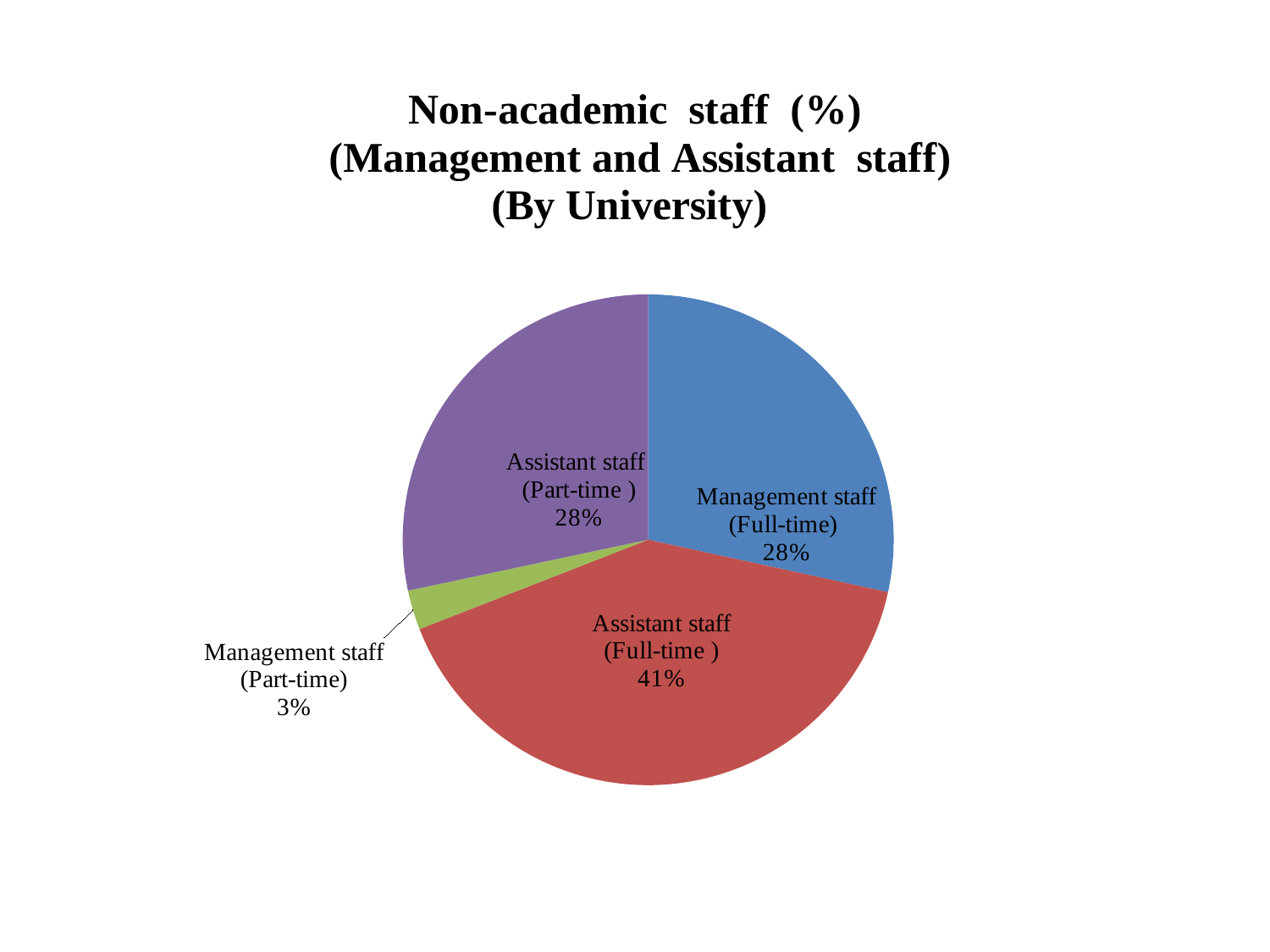
What percentage is shown for Management staff (Part-time)? 3% Which category has the smallest share of the pie? Management staff (Part-time) What kind of chart is shown on the slide? pie chart What is the difference in percentage points between Assistant staff (Full-time) and Management staff (Part-time)? 38 What colour is the slice for Assistant staff (Full-time)? red Which category has the largest share of the pie? Assistant staff (Full-time) What is the title of the chart? Non-academic staff (%) (Management and Assistant staff) (By University) What percentage is shown for Assistant staff (Part-time)? 28% What percentage is shown for Management staff (Full-time)? 28% What percentage is shown for Assistant staff (Full-time)? 41% Which is larger, Assistant staff (Full-time) or Management staff (Full-time)? Assistant staff (Full-time) How many slices does the pie chart have? 4